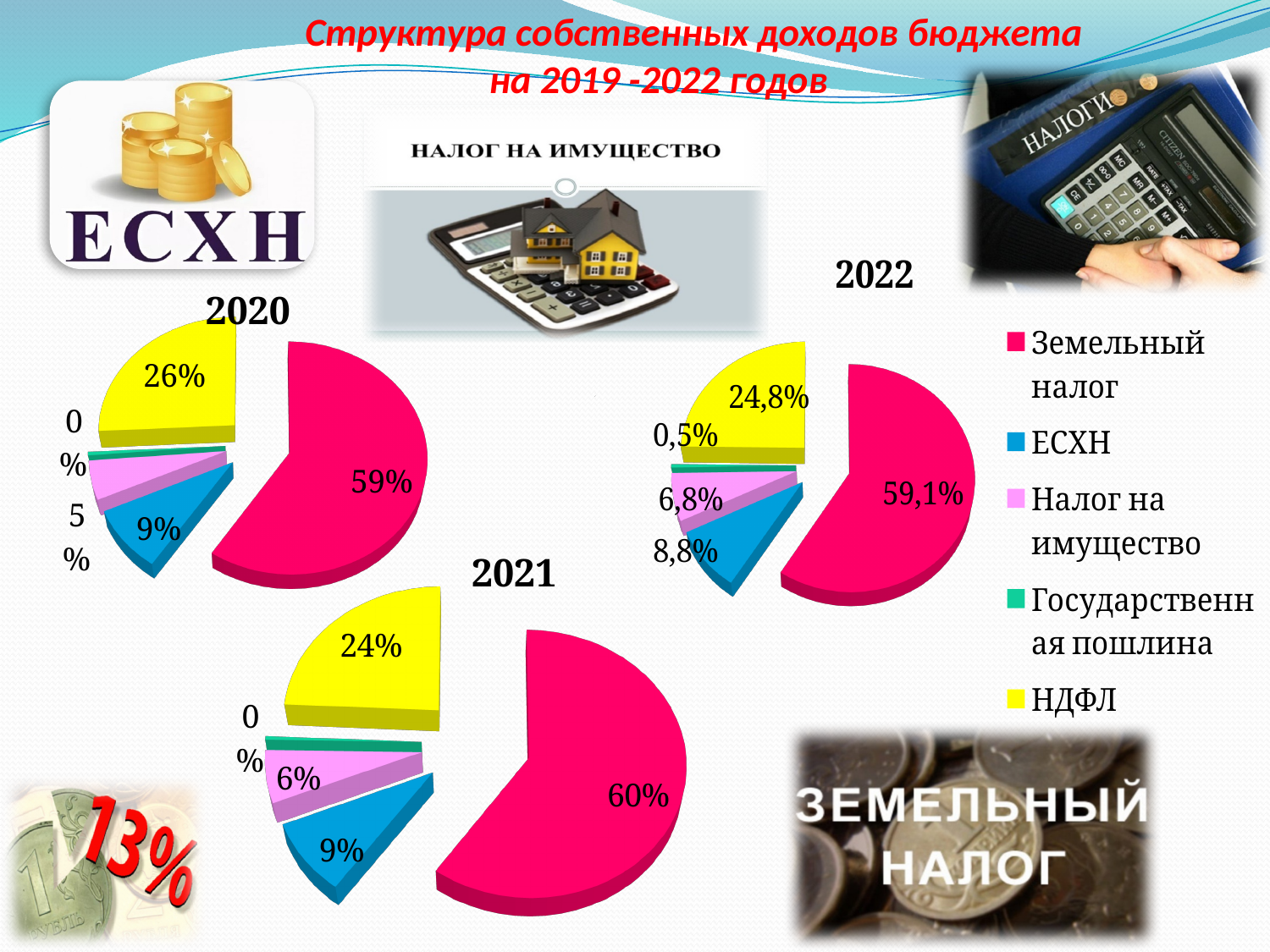
How many pie charts are shown on the slide? 3 In the 2021 pie chart, which category has the smallest share? Государственная пошлина In the 2022 pie chart, what is the difference between the shares of Земельный налог and НДФЛ? 34,3% In the 2020 pie chart, what share does Земельный налог have? 59% Which colour represents НДФЛ in the pie charts? Yellow What kind of chart is used to show the 2020 budget revenue structure? Pie chart In the 2020 pie chart, which category has the largest share? Земельный налог How many categories does the legend list for the pie charts? 5 In the 2022 pie chart, what share does Государственная пошлина have? 0,5% In the 2021 pie chart, which is larger: the share of ЕСХН or the share of Налог на имущество? ЕСХН In the 2021 pie chart, what share does НДФЛ have? 24% In the 2022 pie chart, what share does ЕСХН have? 8,8%